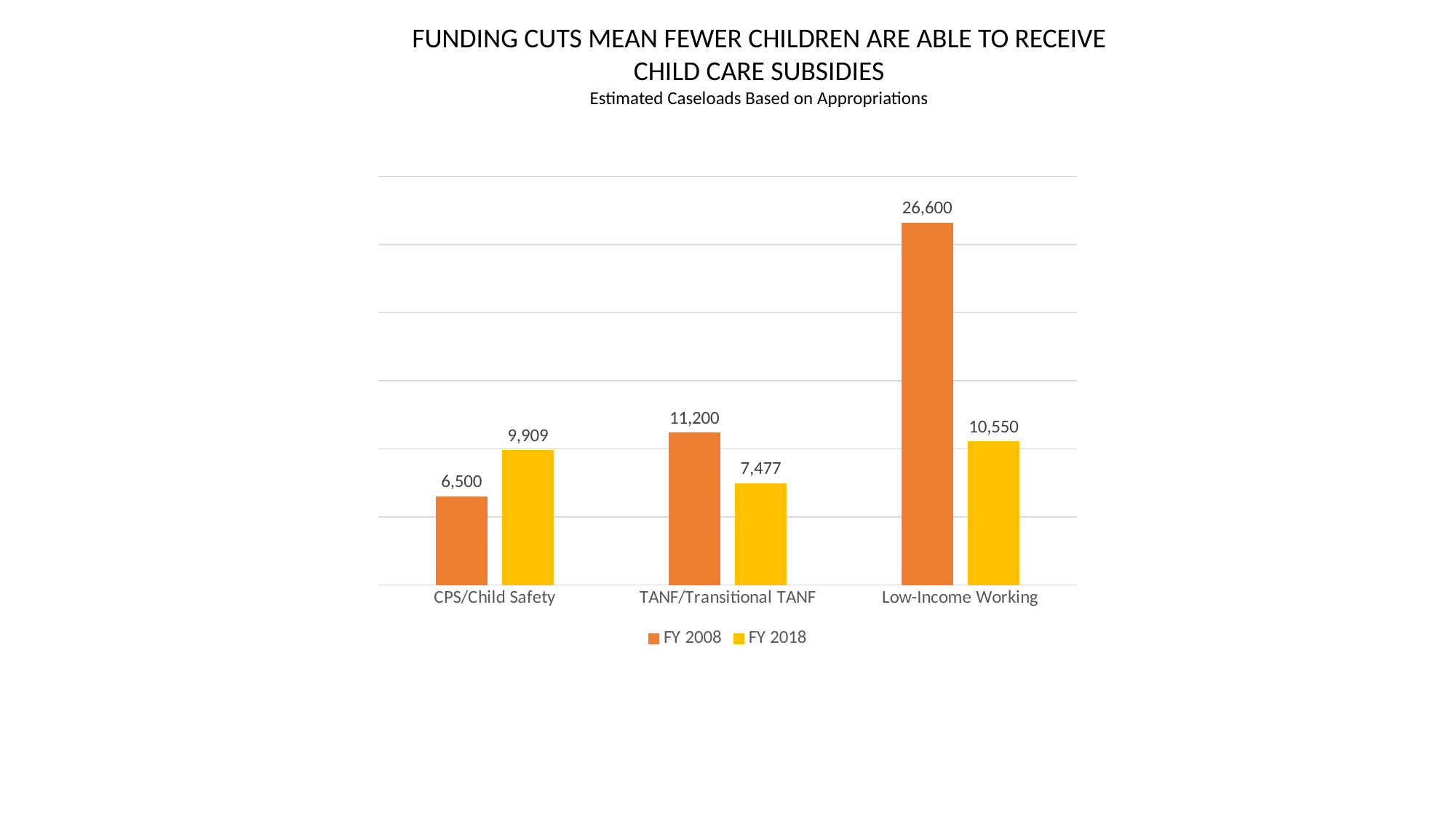
What is the FY 2008 value for TANF/Transitional TANF? 11,200 Which category has the highest FY 2008 value? Low-Income Working What kind of chart is shown on the slide? Bar chart What is the difference between the FY 2008 and FY 2018 values for Low-Income Working? 16,050 How many series does the legend list? 2 Which category has the lowest FY 2018 value? TANF/Transitional TANF What is the FY 2018 value for TANF/Transitional TANF? 7,477 What is the difference between the FY 2018 and FY 2008 values for CPS/Child Safety? 3,409 What is the FY 2018 value for CPS/Child Safety? 9,909 Which is larger for TANF/Transitional TANF, the FY 2008 value or the FY 2018 value? FY 2008 How many categories are shown on the x axis? 3 What is the FY 2008 value for Low-Income Working? 26,600